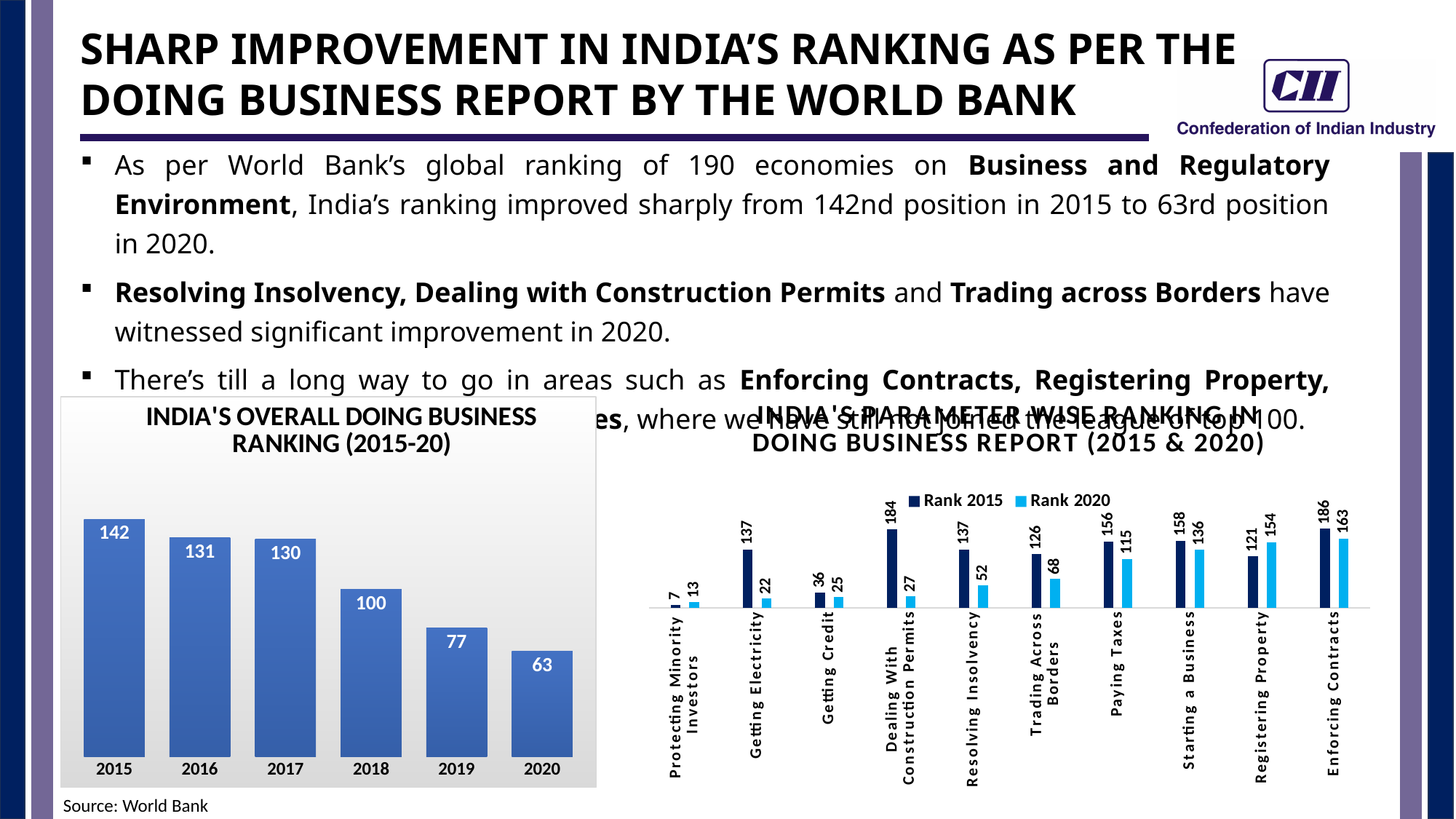
How many series does the legend list in the chart titled "India's Parameter Wise Ranking in Doing Business Report (2015 & 2020)"? 2 In the chart titled "India's Parameter Wise Ranking in Doing Business Report (2015 & 2020)", which parameter has the highest Rank 2015 value? Enforcing Contracts In the chart titled "India's Parameter Wise Ranking in Doing Business Report (2015 & 2020)", what is the difference between the Rank 2015 and Rank 2020 values for Resolving Insolvency? 85 How many years are shown in the chart titled "India's Overall Doing Business Ranking (2015-20)"? 6 In the chart titled "India's Overall Doing Business Ranking (2015-20)", which year has the lowest value? 2020 What type of chart is the chart titled "India's Overall Doing Business Ranking (2015-20)"? bar chart In the chart titled "India's Overall Doing Business Ranking (2015-20)", do the values rise or fall from 2015 to 2020? fall In the chart titled "India's Overall Doing Business Ranking (2015-20)", by how much did the ranking value change from 2015 to 2020? 79 In the chart titled "India's Overall Doing Business Ranking (2015-20)", what was India's ranking in 2018? 100 In the chart titled "India's Parameter Wise Ranking in Doing Business Report (2015 & 2020)", which is larger for Registering Property: Rank 2015 or Rank 2020? Rank 2020 In the chart titled "India's Parameter Wise Ranking in Doing Business Report (2015 & 2020)", what is the Rank 2020 value for Dealing With Construction Permits? 27 In the chart titled "India's Parameter Wise Ranking in Doing Business Report (2015 & 2020)", what is the Rank 2015 value for Getting Electricity? 137